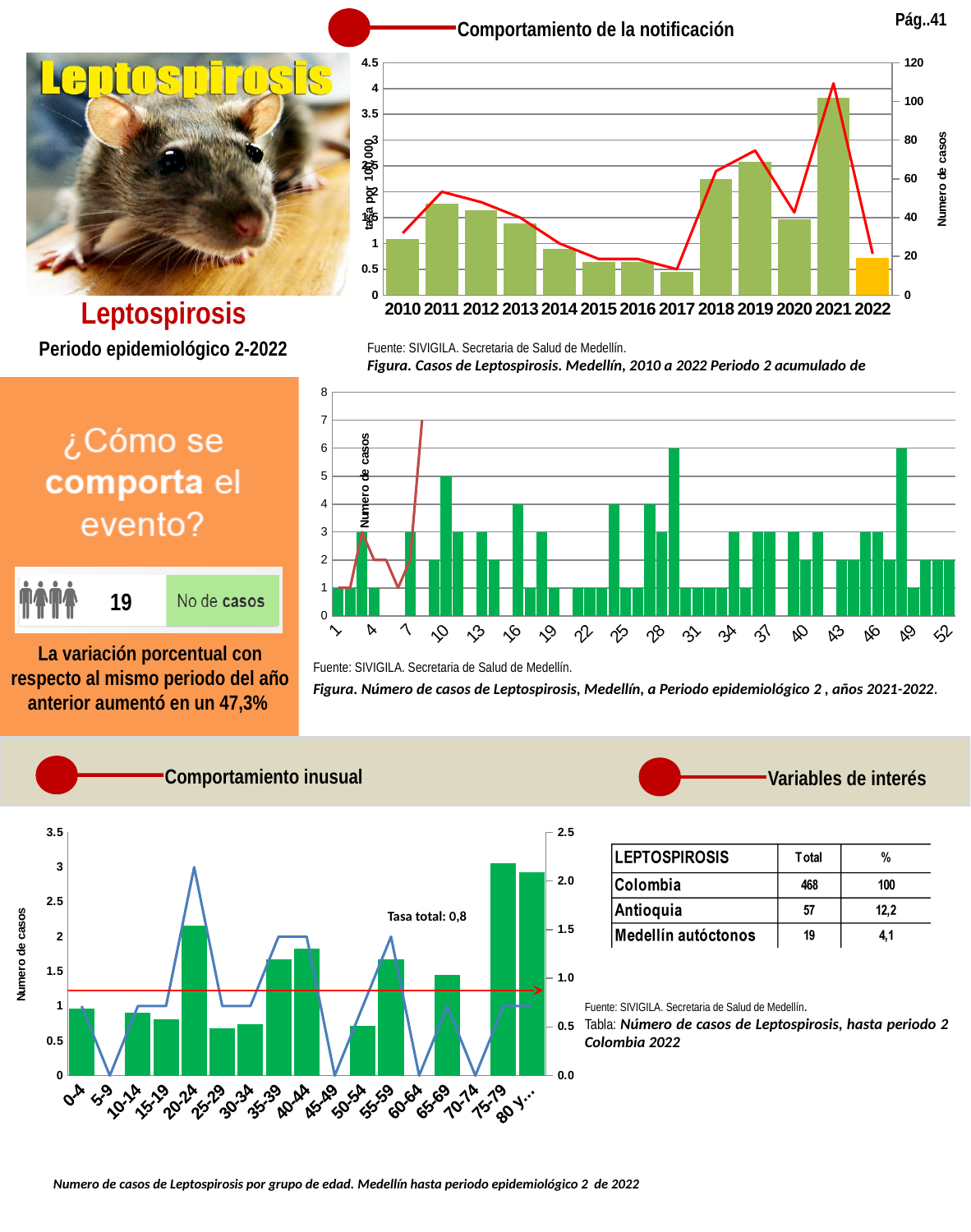
In the top chart 'Casos de Leptospirosis. Medellín, 2010 a 2022', how many years are shown on the x axis? 13 In the bottom-left chart of cases by age group, what value is given for 'Tasa total'? 0,8 In the top chart 'Casos de Leptospirosis. Medellín, 2010 a 2022', which year has the shortest bar? 2017 In the middle chart 'Número de casos de Leptospirosis, Medellín, a Periodo epidemiológico 2, años 2021-2022', what is the number of cases for week 1? 1 In the bottom-left chart of cases by age group, how many age groups are shown on the x axis? 17 In the top chart 'Casos de Leptospirosis. Medellín, 2010 a 2022', is the bar for 2010 greater or less than 40 on the right-hand axis (Numero de casos)? less In the middle chart 'Número de casos de Leptospirosis, Medellín, a Periodo epidemiológico 2, años 2021-2022', what is the highest number of cases reached by any bar? 6 In the top chart 'Casos de Leptospirosis. Medellín, 2010 a 2022', what kind of chart is it? bar chart with a line In the top chart 'Casos de Leptospirosis. Medellín, 2010 a 2022', is the bar for 2021 greater or less than 80 on the right-hand axis (Numero de casos)? greater In the top chart 'Casos de Leptospirosis. Medellín, 2010 a 2022', which bar is taller, 2019 or 2020? 2019 In the top chart 'Casos de Leptospirosis. Medellín, 2010 a 2022', which year's bar is coloured orange instead of green? 2022 In the top chart 'Casos de Leptospirosis. Medellín, 2010 a 2022', which year has the tallest bar? 2021